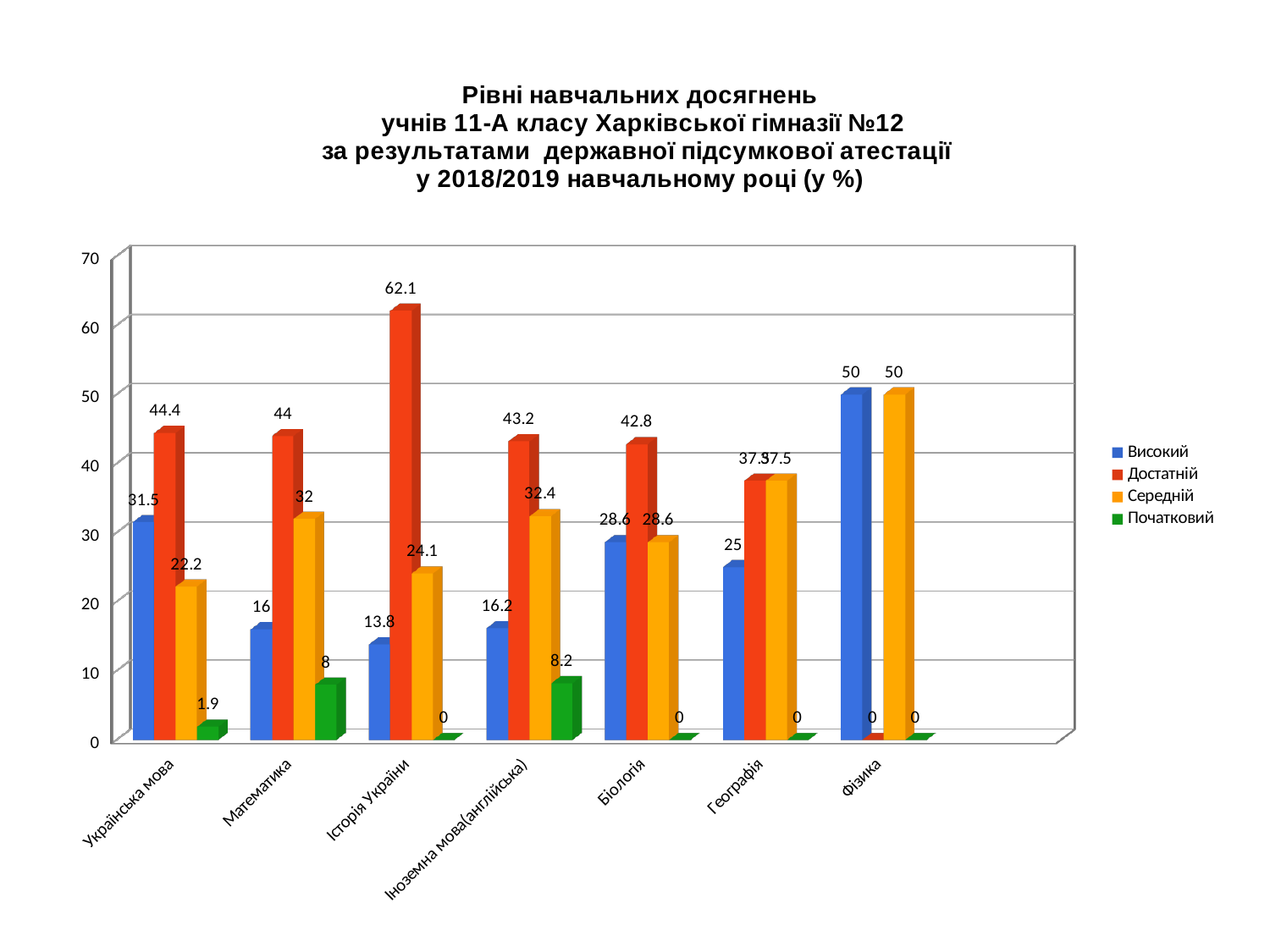
What is the difference between the Достатній and Середній values for Українська мова? 22.2 Which category has the highest Високий value? Фізика What is the value of Високий for Українська мова? 31.5 What kind of chart is shown on the slide? bar chart Which is larger: the Високий value for Біологія or the Високий value for Географія? Біологія How many series does the legend list? 4 Which category has the highest Достатній value? Історія України What is the value of Достатній for Історія України? 62.1 What is the value of Початковий for Математика? 8 How many categories are shown on the x axis? 7 Which series is shown in green in the legend? Початковий What is the value of Середній for Іноземна мова(англійська)? 32.4